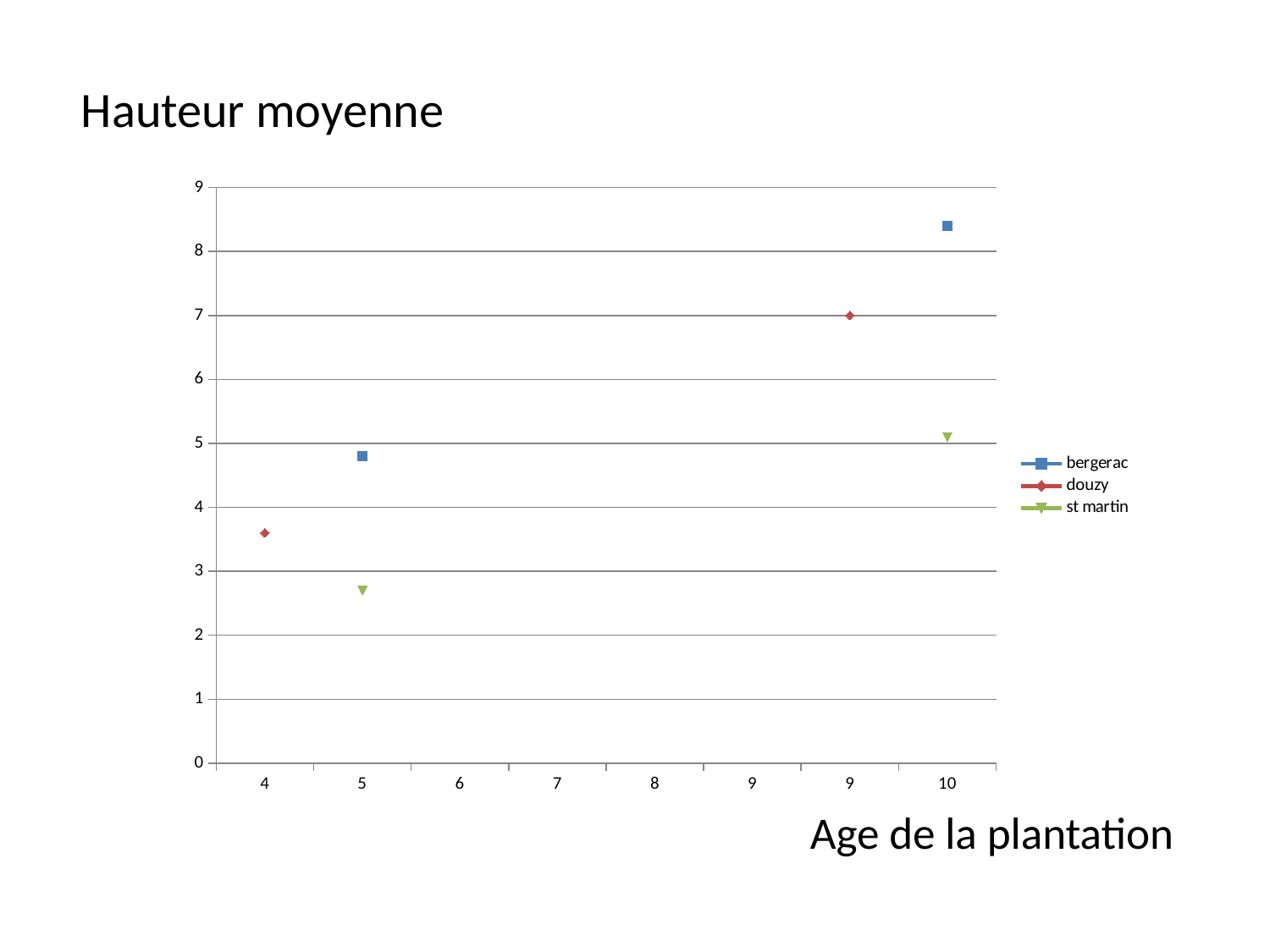
Do the values for bergerac rise or fall from age 5 to age 10? rise What is the value for douzy at age 9? 7 Is the value for douzy at age 4 greater or less than 3? greater Which series has the lowest plotted point on the chart? st martin What kind of chart is shown on the slide? line chart Which series has the highest plotted point on the chart? bergerac At age 5, which series has the larger value, bergerac or st martin? bergerac How many series does the legend list? 3 What is the label of the x axis? Age de la plantation Is the value for st martin at age 5 greater or less than 3? less How many categories are shown along the x axis? 8 Is the value for bergerac at age 10 greater or less than 8? greater